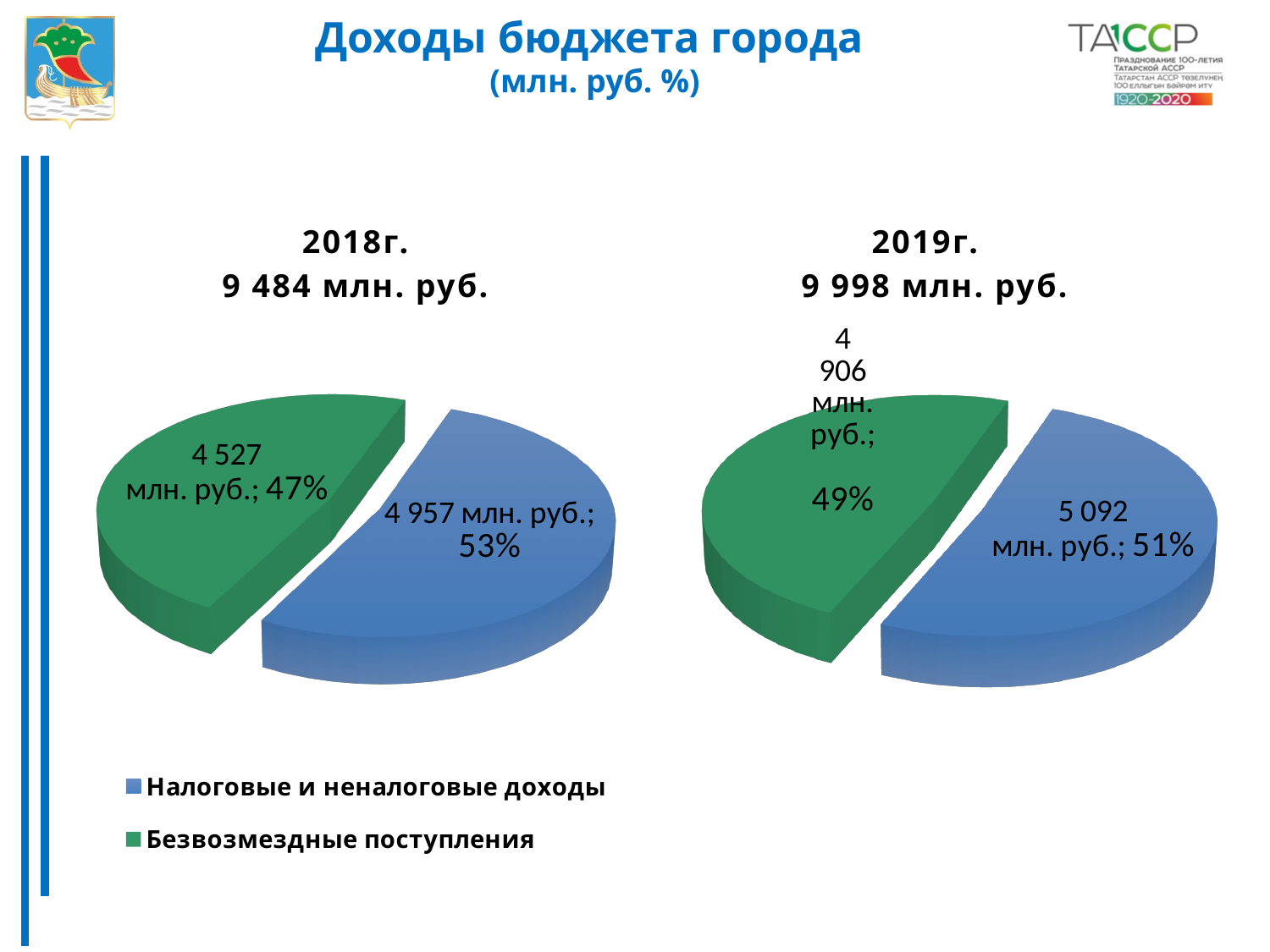
In the 2019г. chart, what is the value for Безвозмездные поступления? 4 906 млн. руб. In the 2018г. chart, what share of the pie is Безвозмездные поступления? 47% What colour represents Безвозмездные поступления in the charts? green In the 2019г. chart, what share of the pie is Налоговые и неналоговые доходы? 51% In the 2018г. chart, which category is the largest? Налоговые и неналоговые доходы How many categories does the legend list? 2 In the 2019г. chart, which category is the smallest? Безвозмездные поступления In the 2018г. chart, what is the value for Налоговые и неналоговые доходы? 4 957 млн. руб. In the 2019г. chart, what is the value for Налоговые и неналоговые доходы? 5 092 млн. руб. In the 2018г. chart, what is the difference between Налоговые и неналоговые доходы and Безвозмездные поступления? 430 млн. руб. What type of chart is used on this slide? pie chart In the 2018г. chart, what is the value for Безвозмездные поступления? 4 527 млн. руб.